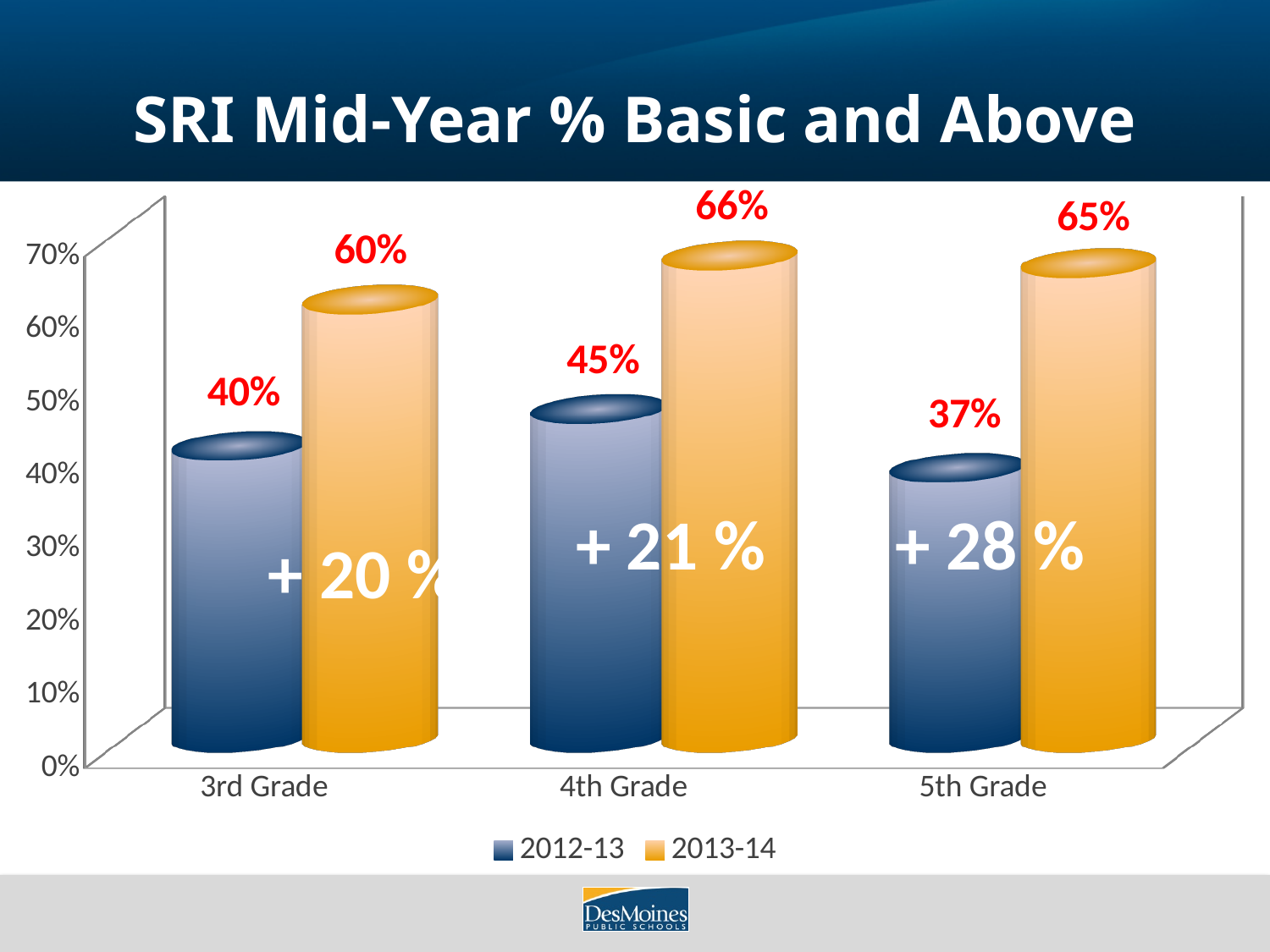
How many grade categories are shown on the x axis? 3 What is the 2012-13 value for 3rd Grade? 40% What kind of chart is shown on the slide? Bar chart What is the 2012-13 value for 5th Grade? 37% What is the 2013-14 value for 4th Grade? 66% What is the difference between the 2013-14 and 2012-13 values for 5th Grade? 28% Which grade has the highest 2013-14 value? 4th Grade Which grade has the lowest 2012-13 value? 5th Grade What is the difference between the 2013-14 and 2012-13 values for 4th Grade? 21% What is the 2013-14 value for 5th Grade? 65% Which is larger, the 2012-13 value for 4th Grade or the 2012-13 value for 3rd Grade? 4th Grade How many series does the legend list? 2